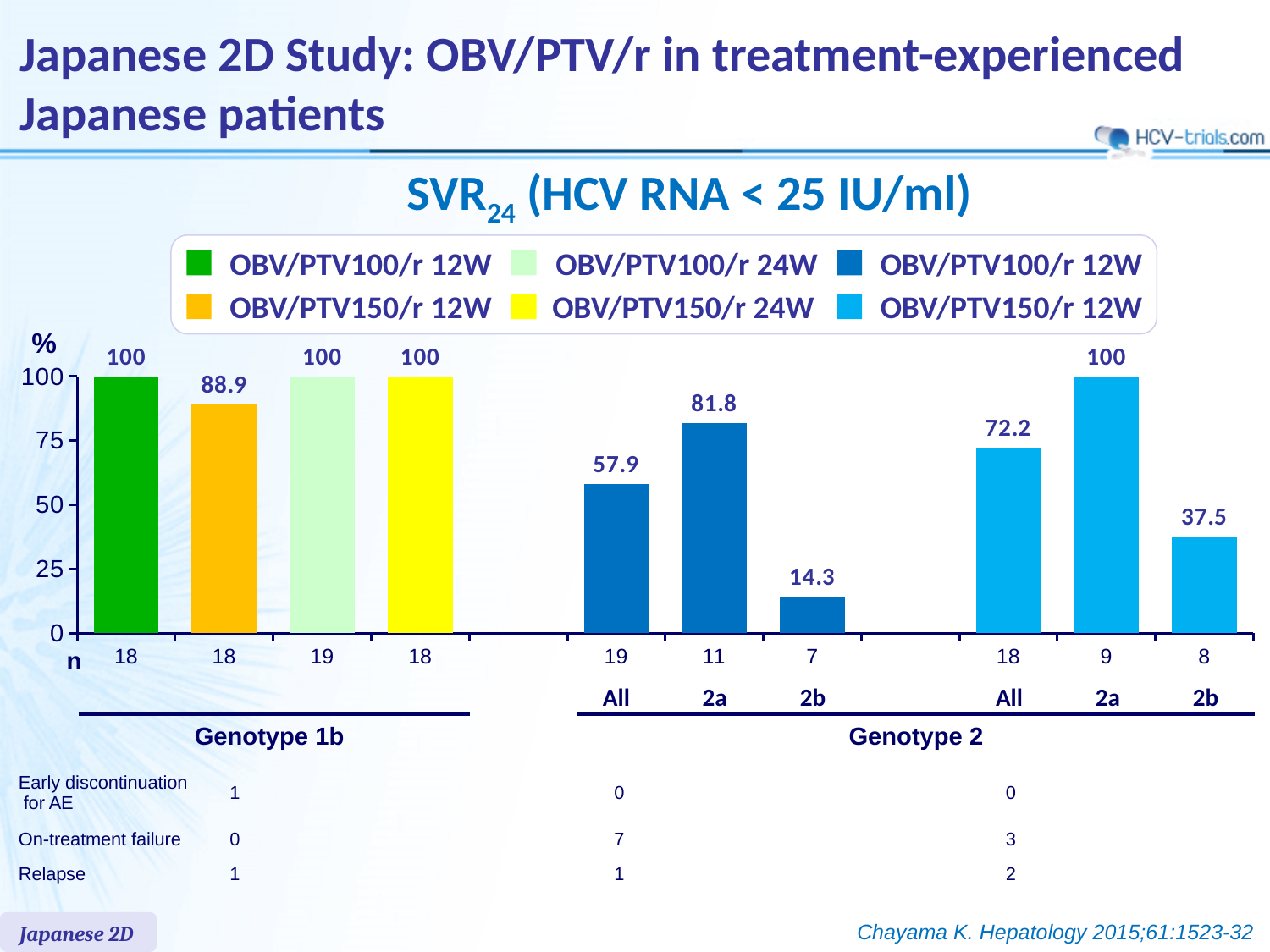
What is the difference in SVR24 rate between the Genotype 2a and Genotype 2b subgroups treated with OBV/PTV150/r 12W? 62.5 How many bars are plotted on the chart in total? 10 What is the SVR24 rate for OBV/PTV150/r 12W in Genotype 1b patients? 88.9 Which Genotype 2 subgroup and regimen has the lowest SVR24 rate on the chart? 2b, OBV/PTV100/r 12W What is the SVR24 rate for the Genotype 2b subgroup treated with OBV/PTV100/r 12W? 14.3 What is the difference in SVR24 rate between all Genotype 2 patients on OBV/PTV150/r 12W and all Genotype 2 patients on OBV/PTV100/r 12W? 14.3 What type of chart is shown on the slide? Bar chart What is the SVR24 rate for all Genotype 2 patients treated with OBV/PTV150/r 12W? 72.2 What is the SVR24 rate for the Genotype 2a subgroup treated with OBV/PTV150/r 12W? 100 How many patients (n) were in the Genotype 2b subgroup treated with OBV/PTV150/r 12W? 8 How many treatment regimens does the legend list? 6 Which has the higher SVR24 rate in Genotype 2a: OBV/PTV100/r 12W or OBV/PTV150/r 12W? OBV/PTV150/r 12W